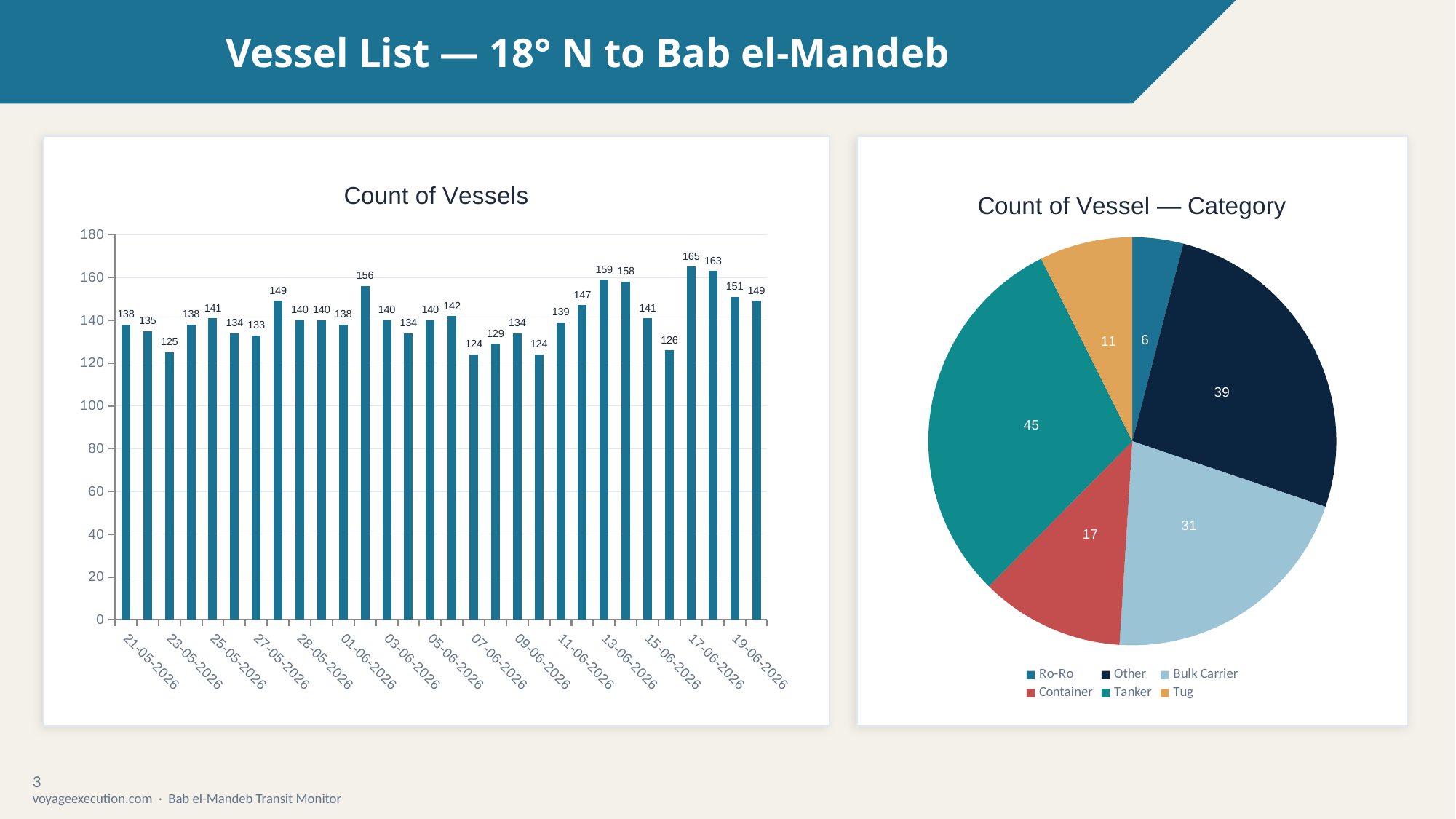
In the "Count of Vessel — Category" pie chart, what is the value for Tanker? 45 In the "Count of Vessel — Category" pie chart, which category has the smallest slice? Ro-Ro In the "Count of Vessels" chart, what is the value for 21-05-2026? 138 In the "Count of Vessel — Category" pie chart, which is larger, Container or Tug? Container In the "Count of Vessels" chart, what is the value for 17-06-2026? 165 How many categories does the legend of the "Count of Vessel — Category" pie chart list? 6 In the "Count of Vessels" chart, what is the lowest value shown? 124 In the "Count of Vessel — Category" pie chart, what is the difference between Other and Bulk Carrier? 8 How many bars are plotted in the "Count of Vessels" chart? 30 What kind of chart is the "Count of Vessel — Category" chart on the right? pie chart In the "Count of Vessels" chart, which date has the highest count? 17-06-2026 What kind of chart is the "Count of Vessels" chart on the left? bar chart